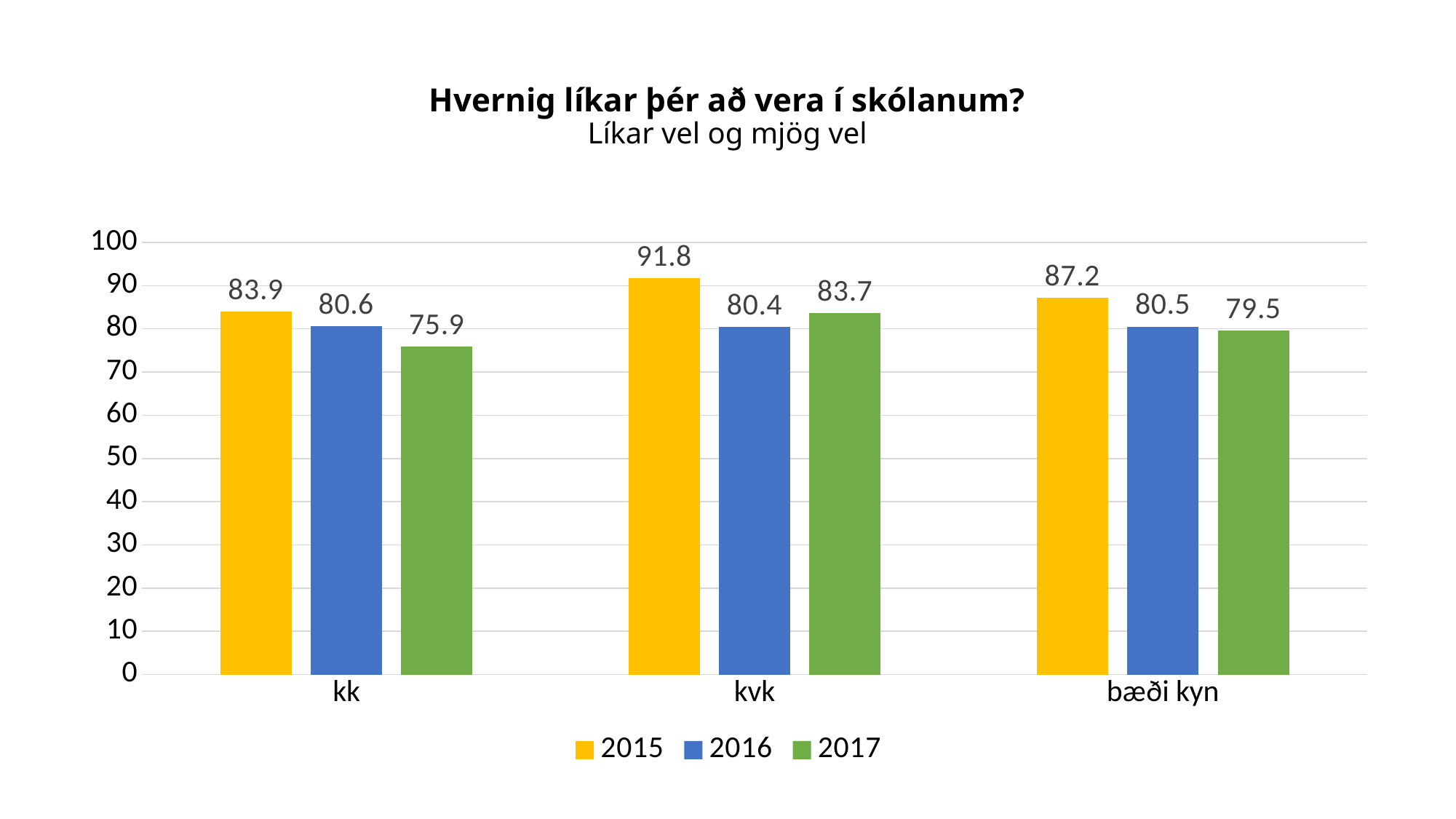
What is the value for kk in 2015? 83.9 How many series does the legend list? 3 Which category has the highest value in the 2015 series? kvk What kind of chart is shown on the slide? bar chart What is the difference between the kvk and kk values in 2015? 7.9 Which category has the lowest value in the 2017 series? kk How many categories are shown on the x axis? 3 Which is larger for kvk: the 2016 value or the 2017 value? 2017 What is the value for kvk in 2017? 83.7 What is the difference between the 2015 and 2017 values for kk? 8 What is the value for bæði kyn in 2016? 80.5 Is the value for kvk in 2015 greater or less than 90? greater